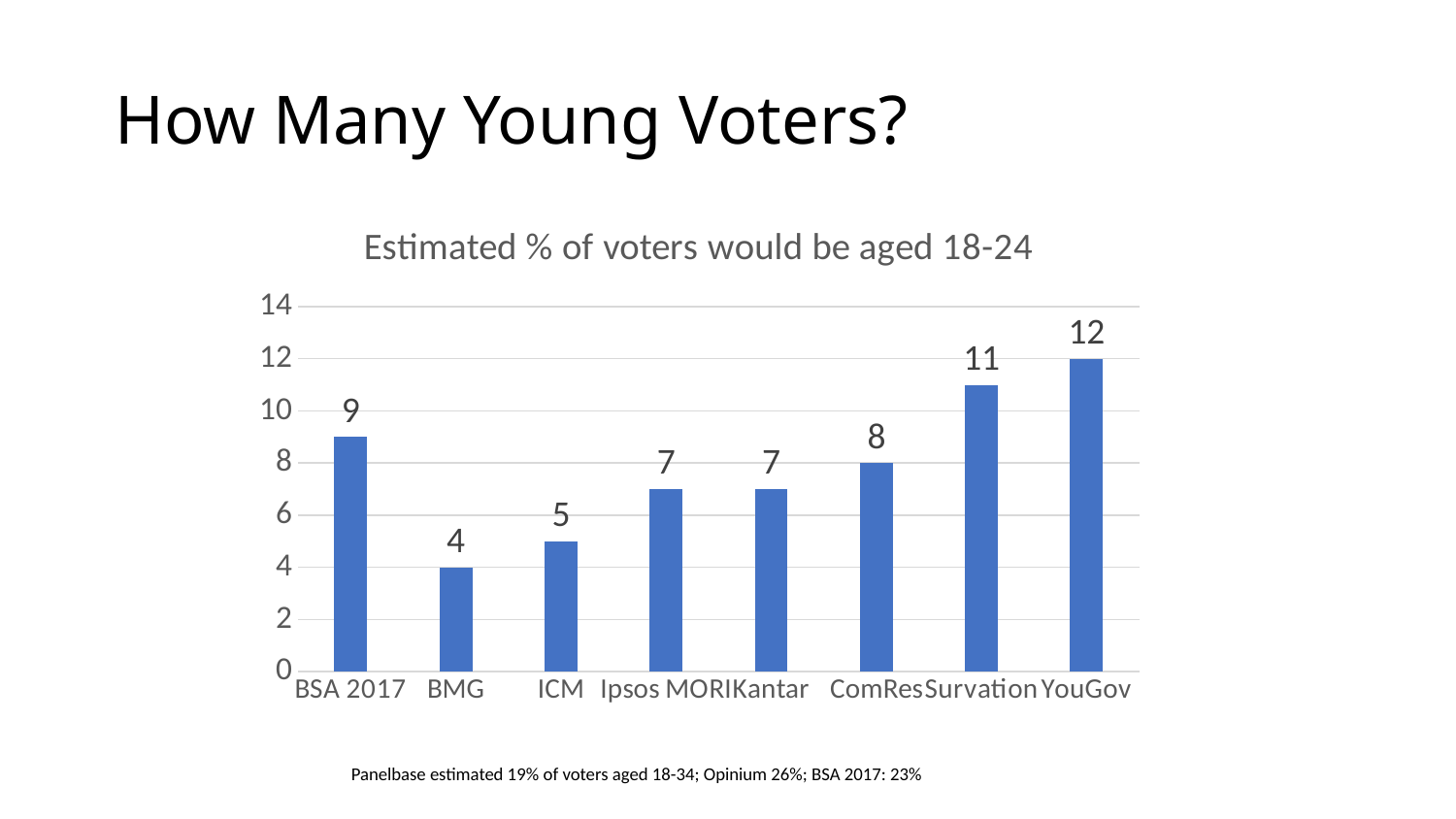
What is the estimated % of voters aged 18-24 for YouGov? 12 Is the value for Survation greater or less than 10? greater What is the title of the chart? Estimated % of voters would be aged 18-24 What value is shown for Survation? 11 Which is larger, the value for ComRes or the value for Kantar? ComRes What kind of chart is shown on the slide? Bar chart What is the difference between the values for BSA 2017 and ICM? 4 Which pollster has the highest estimated % of voters aged 18-24? YouGov What is the difference between the values for YouGov and BMG? 8 What value is shown for BMG? 4 How many pollsters are shown on the x axis? 8 Which pollster has the lowest estimated % of voters aged 18-24? BMG